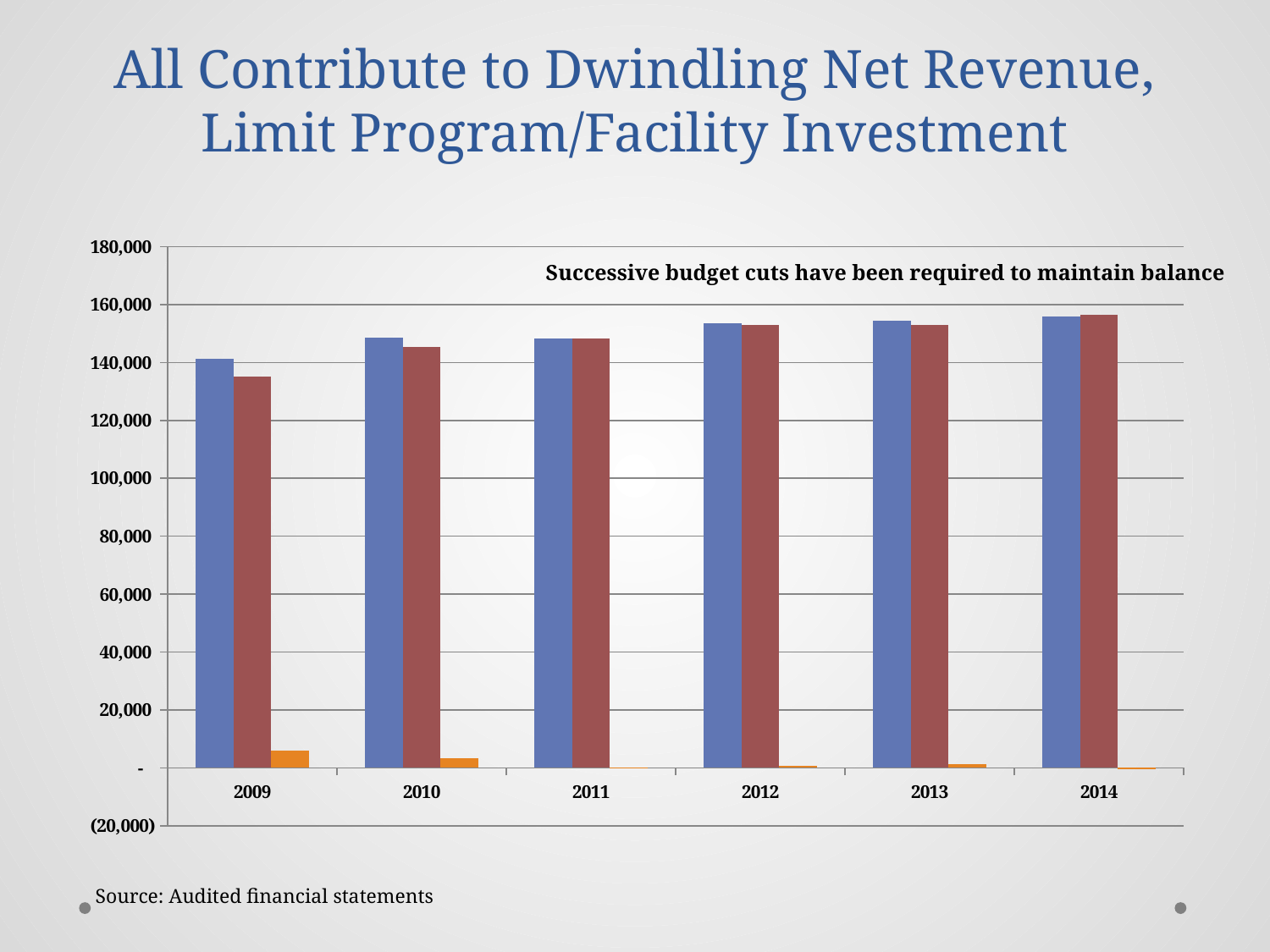
What kind of chart is shown on the slide? Bar chart Is the value of the red bar for 2009 greater or less than 140,000? less Is the value of the orange bar for 2009 greater or less than 20,000? less Is the value of the red bar for 2010 greater or less than 140,000? greater How many years are shown on the x axis of the chart? 6 Do the blue bars generally rise or fall from 2009 to 2014? Rise How many bars are plotted for each year in the chart? 3 In which year is the blue bar lowest? 2009 In which year is the orange bar highest? 2009 In 2009, which is larger, the blue bar or the red bar? The blue bar What annotation text is printed inside the chart area? Successive budget cuts have been required to maintain balance